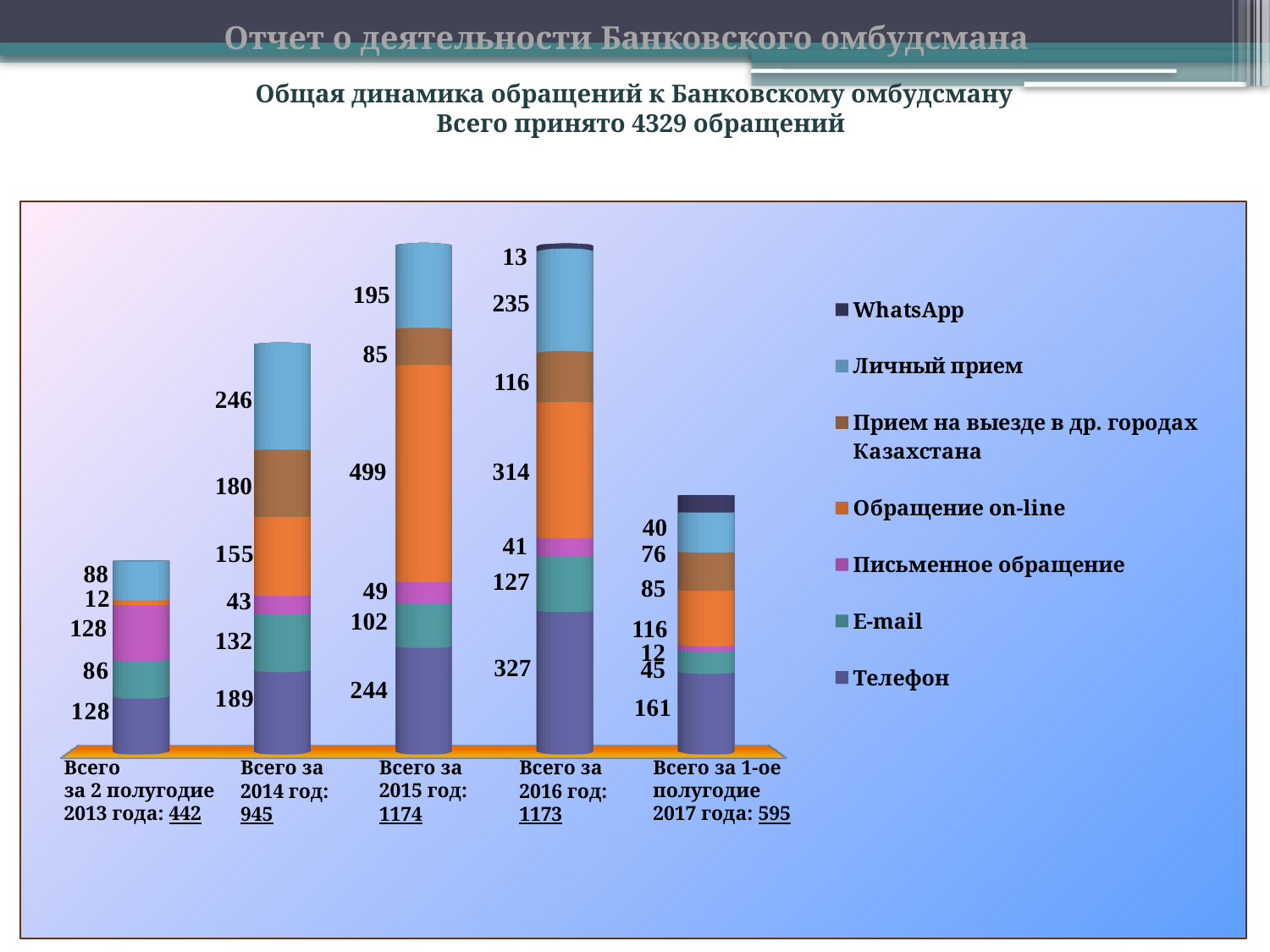
What is the value for WhatsApp in the bar for 1-ое полугодие 2017 года? 40 Does the value for Телефон rise or fall from 2 полугодие 2013 года to 2016 год? rise What kind of chart is shown on the slide? stacked bar chart What is the value for Обращение on-line in the bar for 2015 год? 499 What is the value for E-mail in the bar for 2014 год? 132 What is the difference between Личный прием in 2014 год and in 2 полугодие 2013 года? 158 Which period has the lowest total number of обращений? 2 полугодие 2013 года Which is larger: Телефон in 2015 год or Телефон in 2014 год? 2015 год What is the value for Телефон in the bar for 2016 год? 327 What is the total of the stacked bar for 2015 год? 1174 How many periods (bars) are plotted on the chart? 5 How many series does the legend list? 7